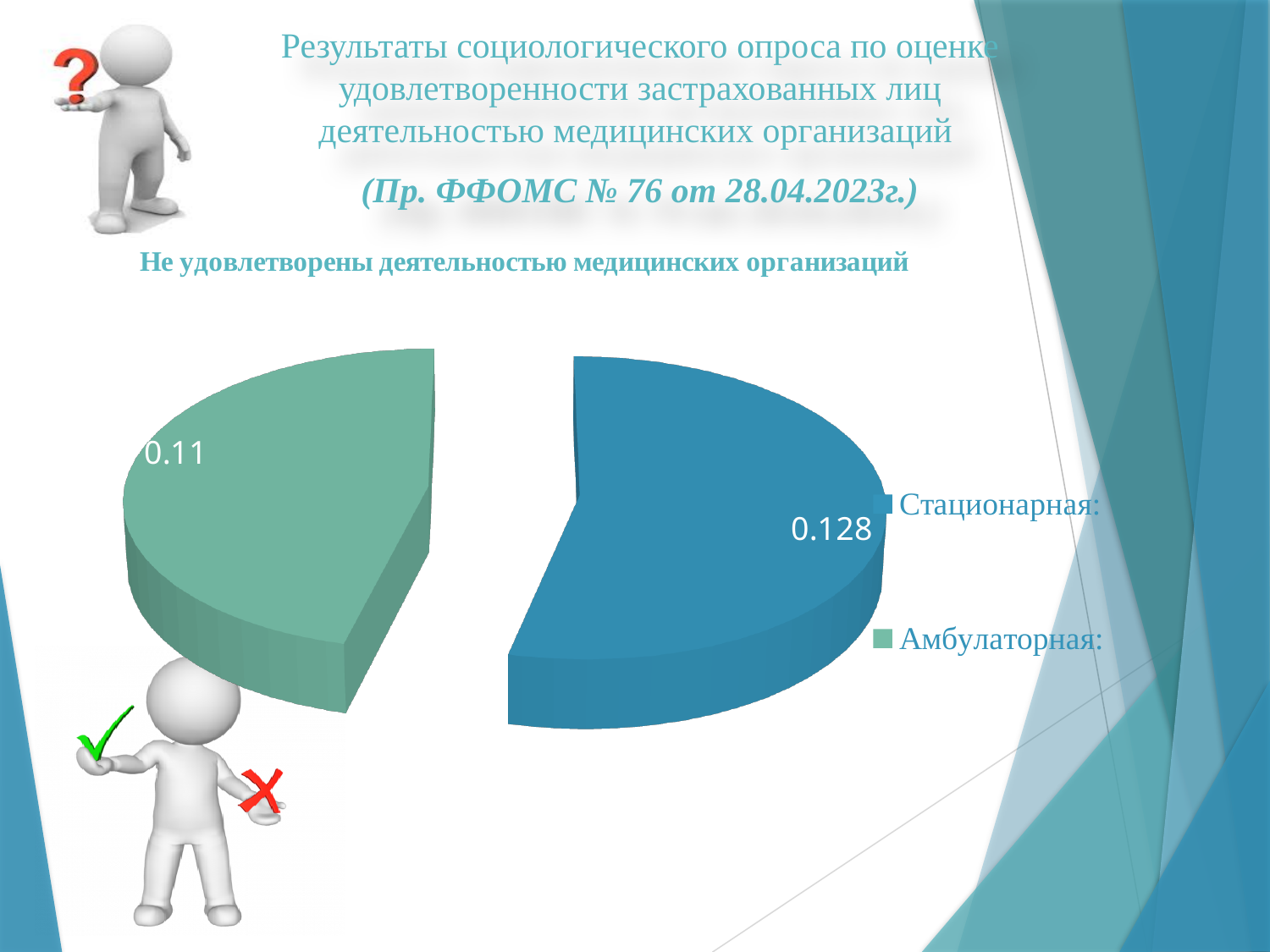
Which category has the smaller value in the pie chart? Амбулаторная What is the difference between the values for Стационарная and Амбулаторная? 0.018 How many slices does the pie chart have? 2 What is the value for Амбулаторная in the pie chart? 0.11 What is the value for Стационарная in the pie chart? 0.128 How many entries does the legend list? 2 Which legend entry is shown in blue? Стационарная Is the value for Стационарная larger or smaller than the value for Амбулаторная? Larger What type of chart is shown on the slide? Pie chart What is the title shown above the pie chart? Не удовлетворены деятельностью медицинских организаций Which category has the larger value in the pie chart? Стационарная